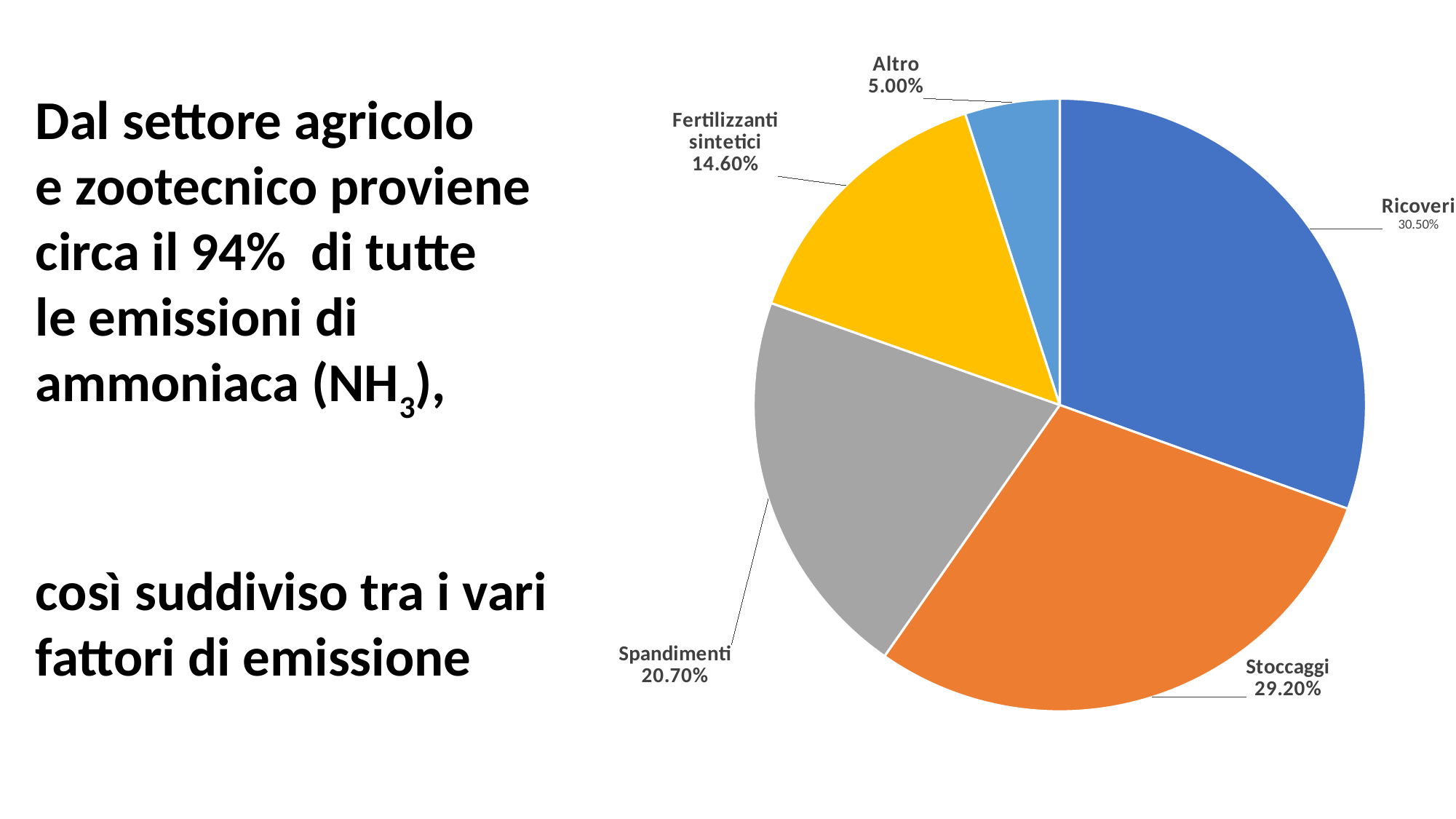
What type of chart is shown on the slide? Pie chart How many slices does the pie chart have? 5 What is the difference between the Spandimenti and Fertilizzanti sintetici shares? 6.10% What is the value shown for Stoccaggi? 29.20% What share is shown for Altro? 5.00% What is the value for Fertilizzanti sintetici? 14.60% What percentage is labelled for Spandimenti? 20.70% Which is larger, Spandimenti or Fertilizzanti sintetici? Spandimenti Which category has the largest slice of the pie? Ricoveri What share of the pie does Ricoveri represent? 30.50% Which category has the smallest slice of the pie? Altro What is the difference between the Ricoveri and Stoccaggi shares? 1.30%